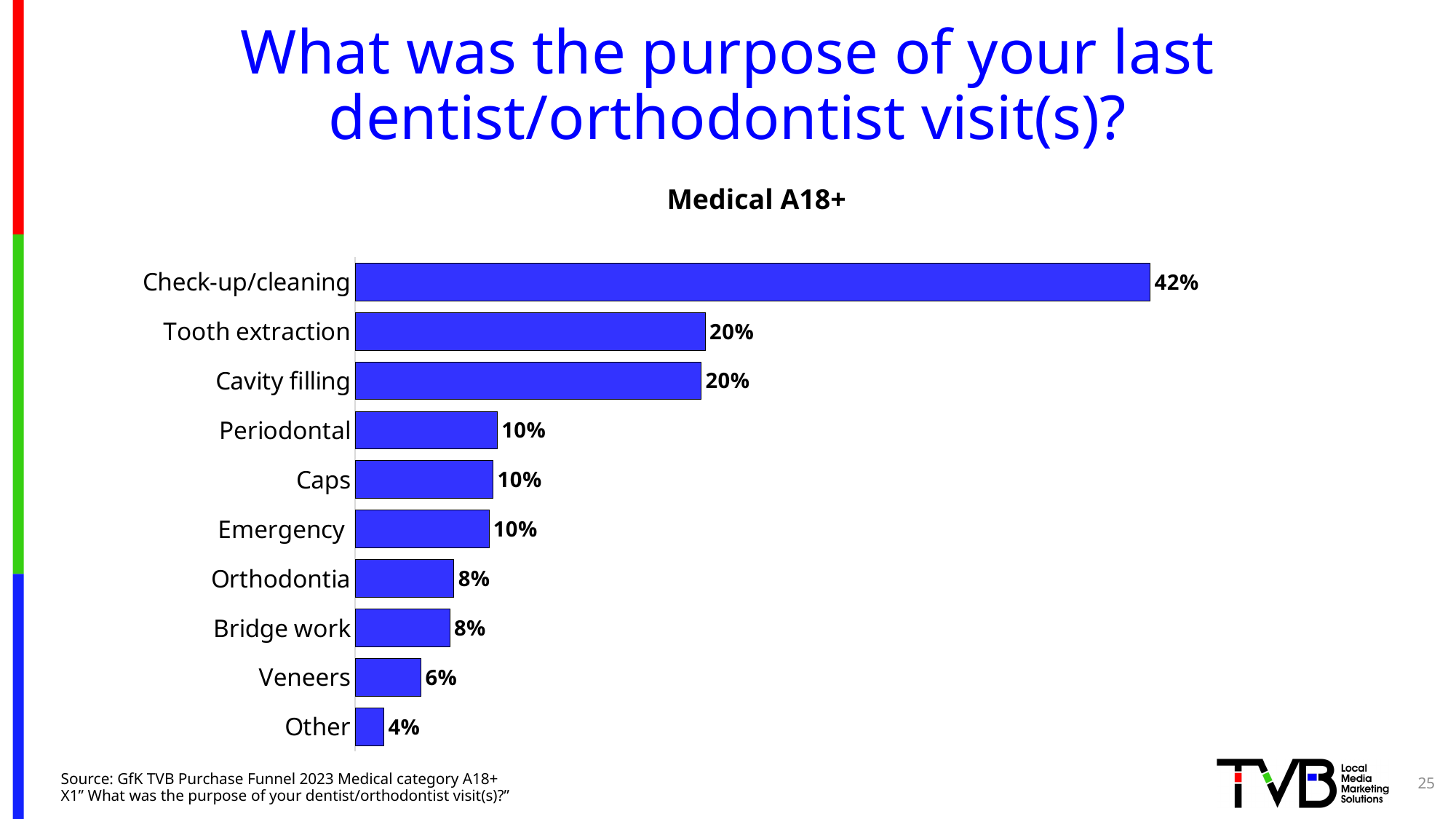
What is the difference between the Check-up/cleaning value and the Cavity filling value? 22 percentage points How many purpose categories are shown in the chart? 10 What is the value shown for Veneers? 6% Which purpose has the lowest percentage? Other What type of chart is shown on the slide? Bar chart Which purpose has the highest percentage? Check-up/cleaning What is the value shown for Tooth extraction? 20% What is the title shown above the chart? Medical A18+ What is the value shown for Orthodontia? 8% What percentage of respondents said the purpose of their last dentist/orthodontist visit was Check-up/cleaning? 42% Which is larger, the value for Bridge work or the value for Emergency? Emergency What is the difference between the Periodontal value and the Other value? 6 percentage points